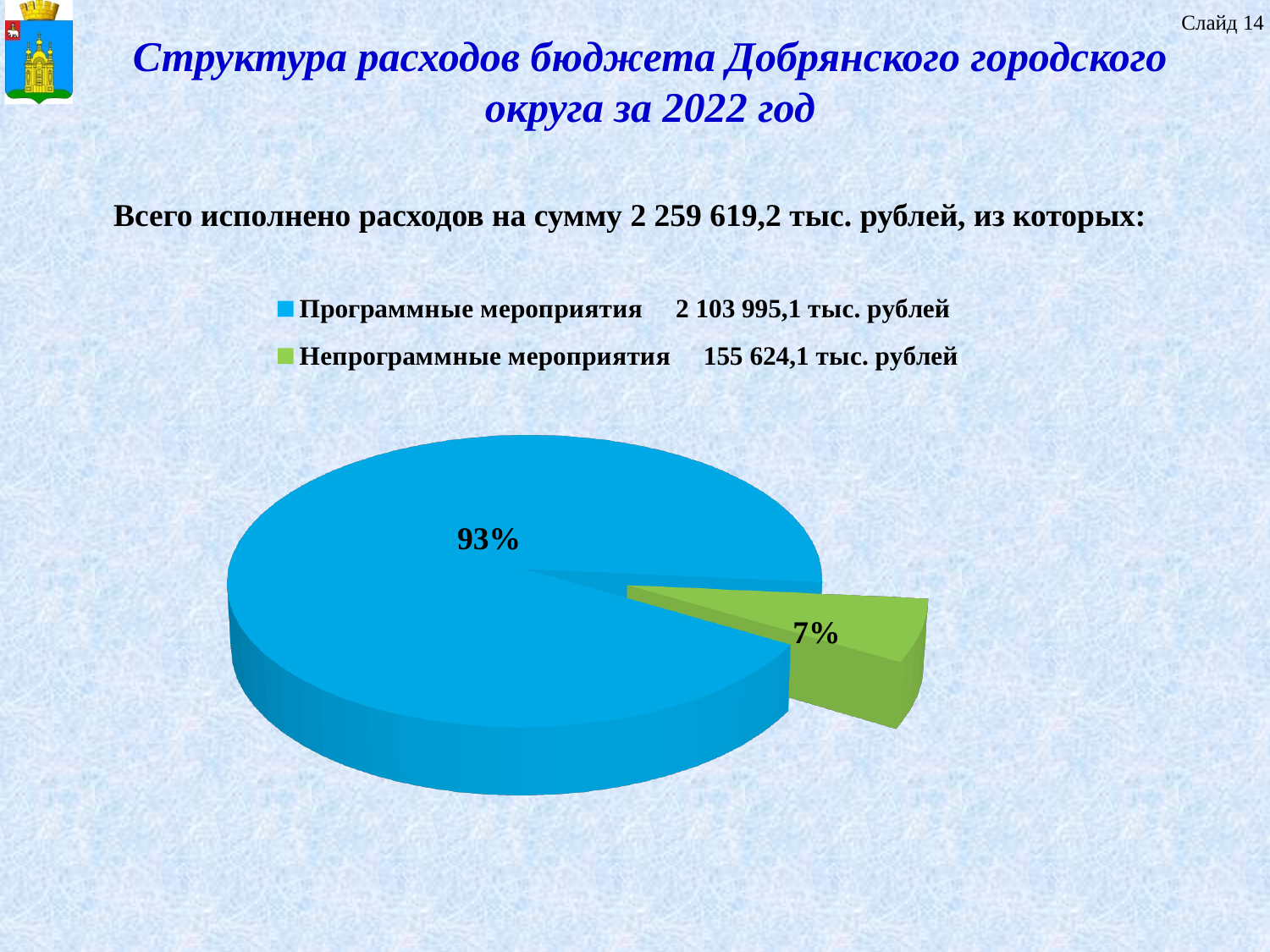
What is the difference in percentage points between the Программные мероприятия slice and the Непрограммные мероприятия slice? 86 What colour is the slice for Непрограммные мероприятия? green What amount in thousand rubles is given in the legend for Непрограммные мероприятия? 155 624,1 тыс. рублей What amount in thousand rubles is given in the legend for Программные мероприятия? 2 103 995,1 тыс. рублей How many entries does the legend list? 2 Which category has the largest slice of the pie? Программные мероприятия How many slices does the pie chart have? 2 What kind of chart is shown on the slide? pie chart Which category has the smallest slice of the pie? Непрограммные мероприятия What share of the pie does Программные мероприятия take? 93% What share of the pie does Непрограммные мероприятия take? 7% Which is larger: the slice for Программные мероприятия or the slice for Непрограммные мероприятия? Программные мероприятия